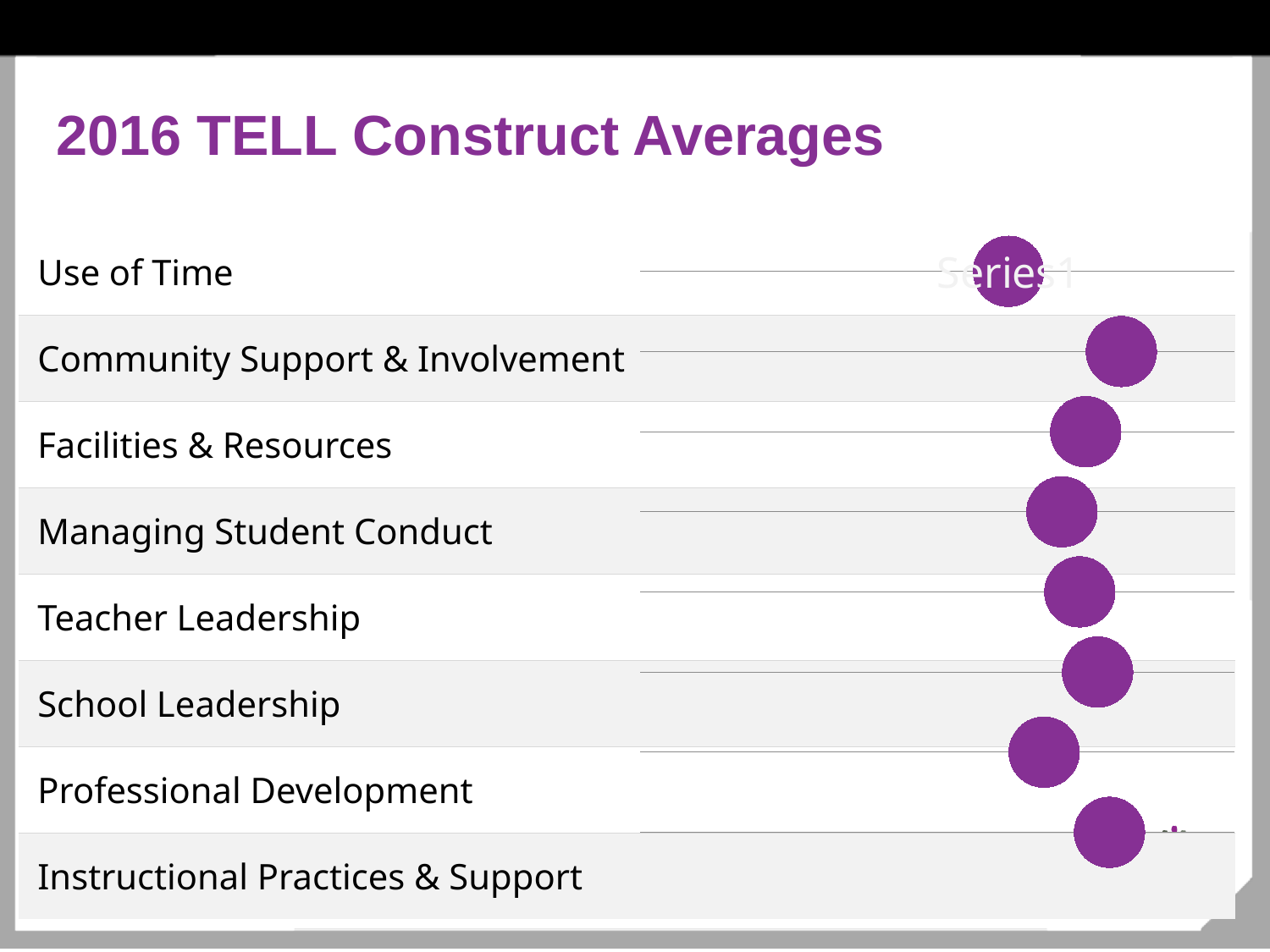
Which is larger, the value for Professional Development or the value for Instructional Practices & Support? Instructional Practices & Support What is the title of the chart on the slide? 2016 TELL Construct Averages How many categories are plotted in the chart? 8 Which category has the lowest value in the chart? Use of Time Which is larger, the value for Use of Time or the value for Facilities & Resources? Facilities & Resources What is the first category listed at the top of the chart? Use of Time Which is larger, the value for Use of Time or the value for Community Support & Involvement? Community Support & Involvement